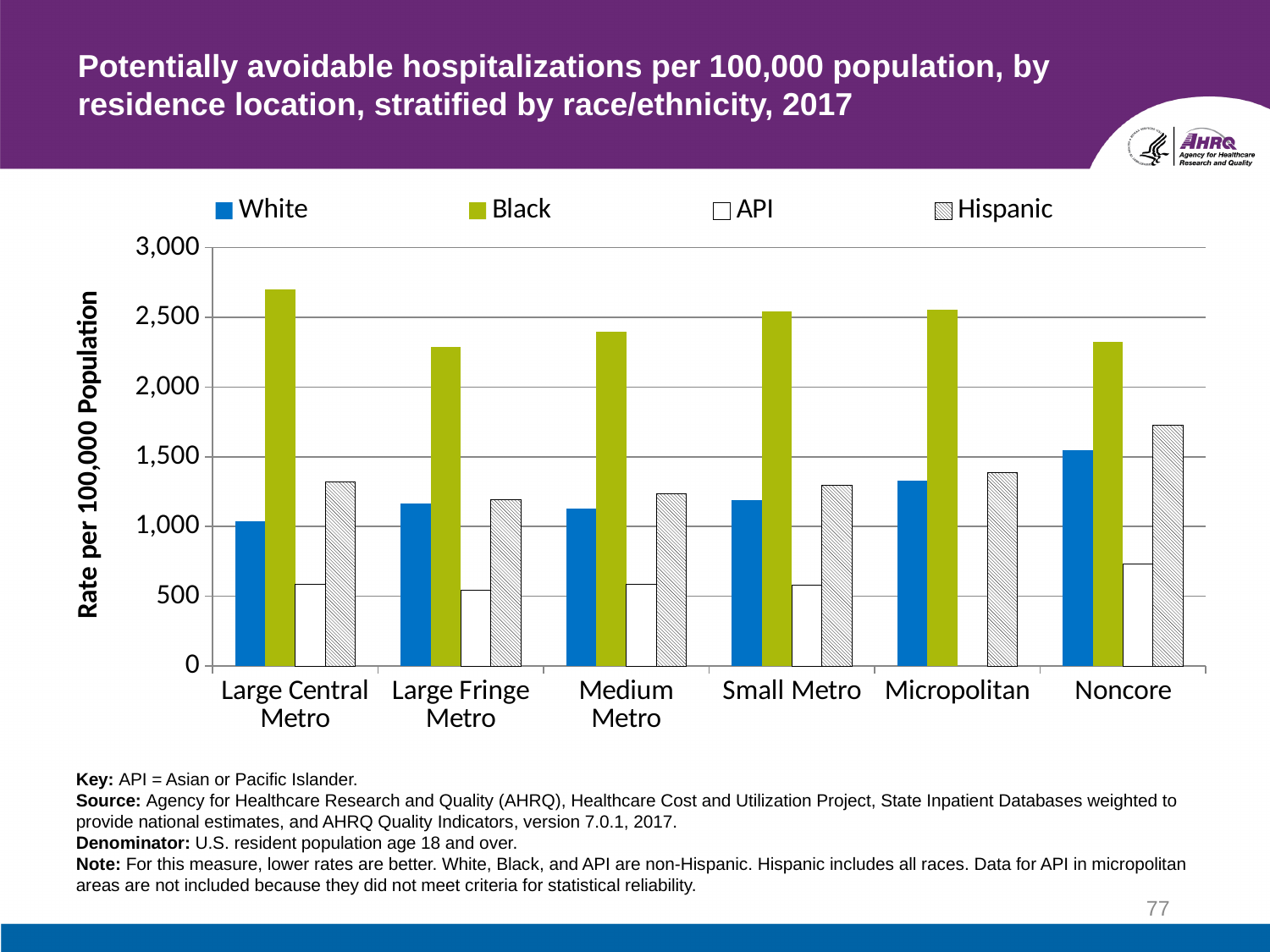
How many series does the legend list? 4 Is the Hispanic value for Noncore greater or less than 1,500? greater Is the Black value for Large Central Metro greater or less than 2,500? greater In which residence location is the Black rate highest? Large Central Metro In which residence location is the White rate lowest? Large Central Metro In which residence location is the Hispanic rate highest? Noncore Is the API value for Noncore greater or less than 1,000? less What is the title of the y axis? Rate per 100,000 Population How many residence location categories are shown on the x axis? 6 What kind of chart is shown on the slide? bar chart Which series has no bar shown for Micropolitan? API In Noncore, which is larger, the White value or the Hispanic value? Hispanic